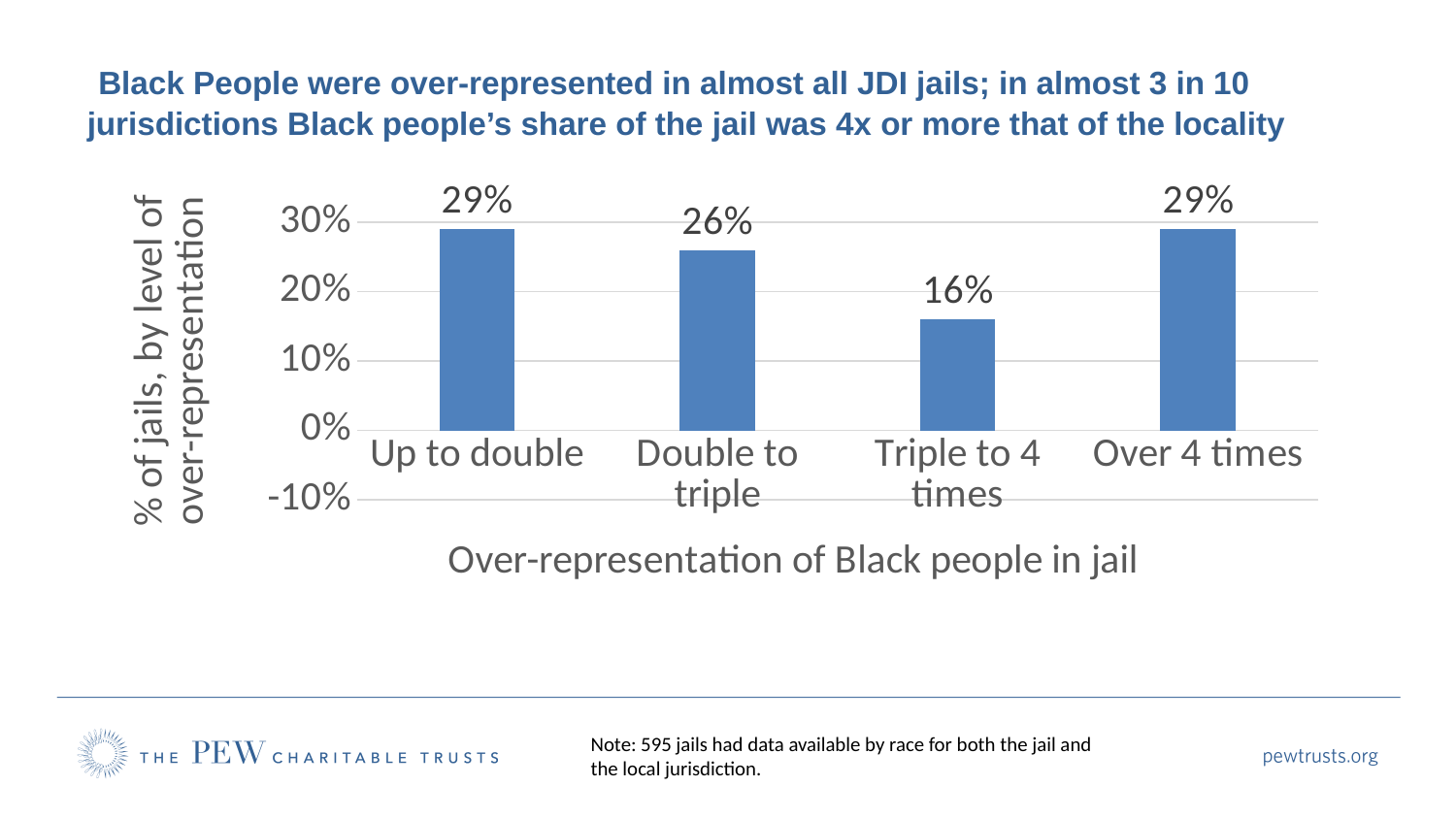
What is the difference between the 'Up to double' and 'Double to triple' values? 3% What is the value for the 'Over 4 times' category? 29% What is the value for the 'Triple to 4 times' category? 16% What is the value for the 'Double to triple' category? 26% Is the value for 'Triple to 4 times' greater or less than 20%? less How many categories are shown on the x axis? 4 Which category has the lowest percentage of jails? Triple to 4 times What kind of chart is shown on the slide? Bar chart Which is larger, the value for 'Double to triple' or the value for 'Triple to 4 times'? Double to triple What is the difference between the 'Double to triple' and 'Triple to 4 times' values? 10% What is the x-axis title of the chart? Over-representation of Black people in jail What percentage of jails fall in the 'Up to double' over-representation category? 29%